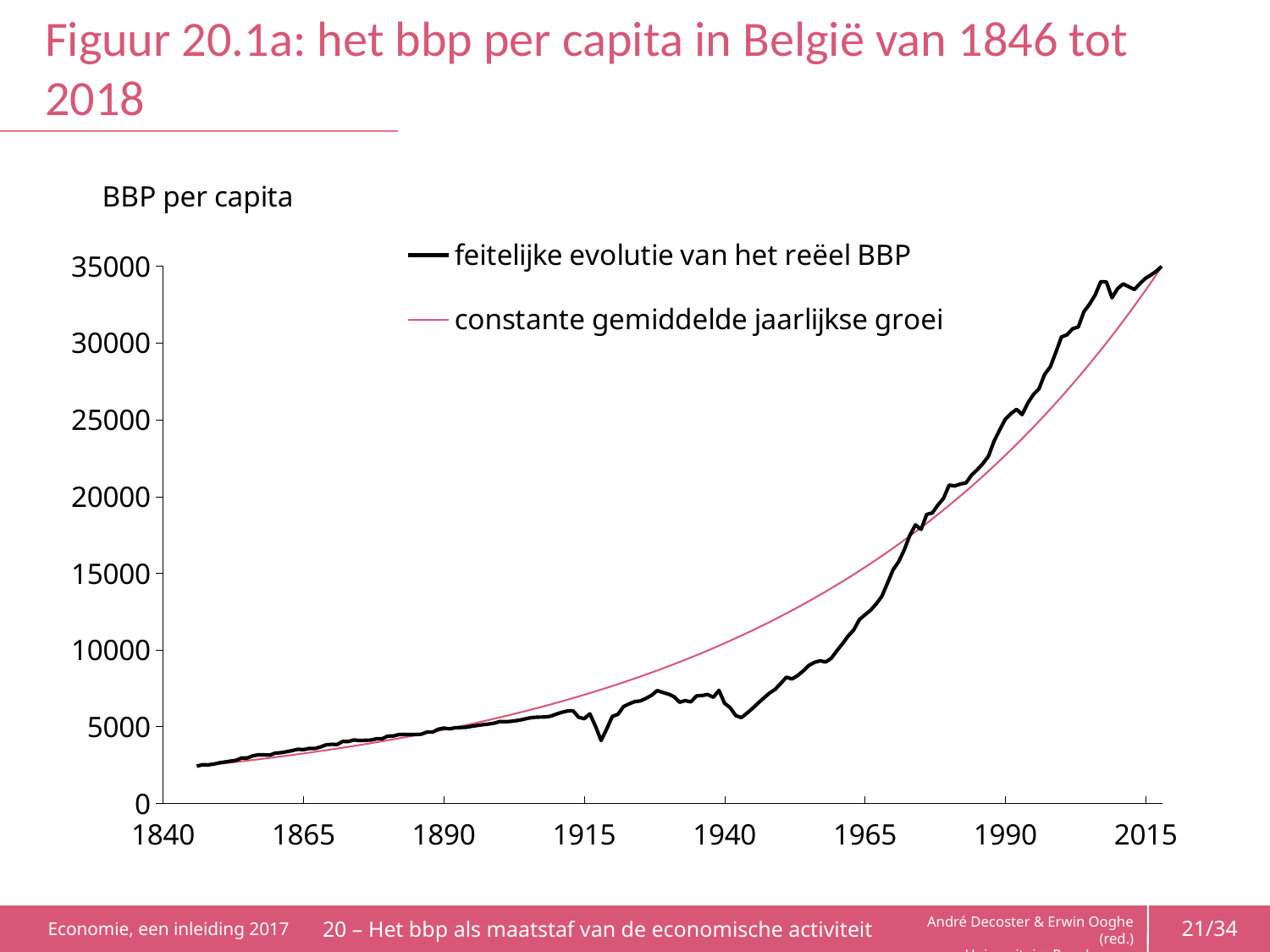
Which series is drawn with the thick black line? feitelijke evolutie van het reëel BBP Does the 'feitelijke evolutie van het reëel BBP' line generally rise or fall from 1840 to 2015? rise In 1940, which series has the higher value: 'feitelijke evolutie van het reëel BBP' or 'constante gemiddelde jaarlijkse groei'? constante gemiddelde jaarlijkse groei Is the value of 'constante gemiddelde jaarlijkse groei' in 1915 greater or less than 10000? less Is the value of 'feitelijke evolutie van het reëel BBP' in 2015 greater or less than 30000? greater Is the value of 'feitelijke evolutie van het reëel BBP' in 1940 greater or less than 10000? less What kind of chart is shown on the slide? line chart How many series does the legend list? 2 In 1990, which series has the higher value: 'feitelijke evolutie van het reëel BBP' or 'constante gemiddelde jaarlijkse groei'? feitelijke evolutie van het reëel BBP What is the title of the figure on the slide? Figuur 20.1a: het bbp per capita in België van 1846 tot 2018